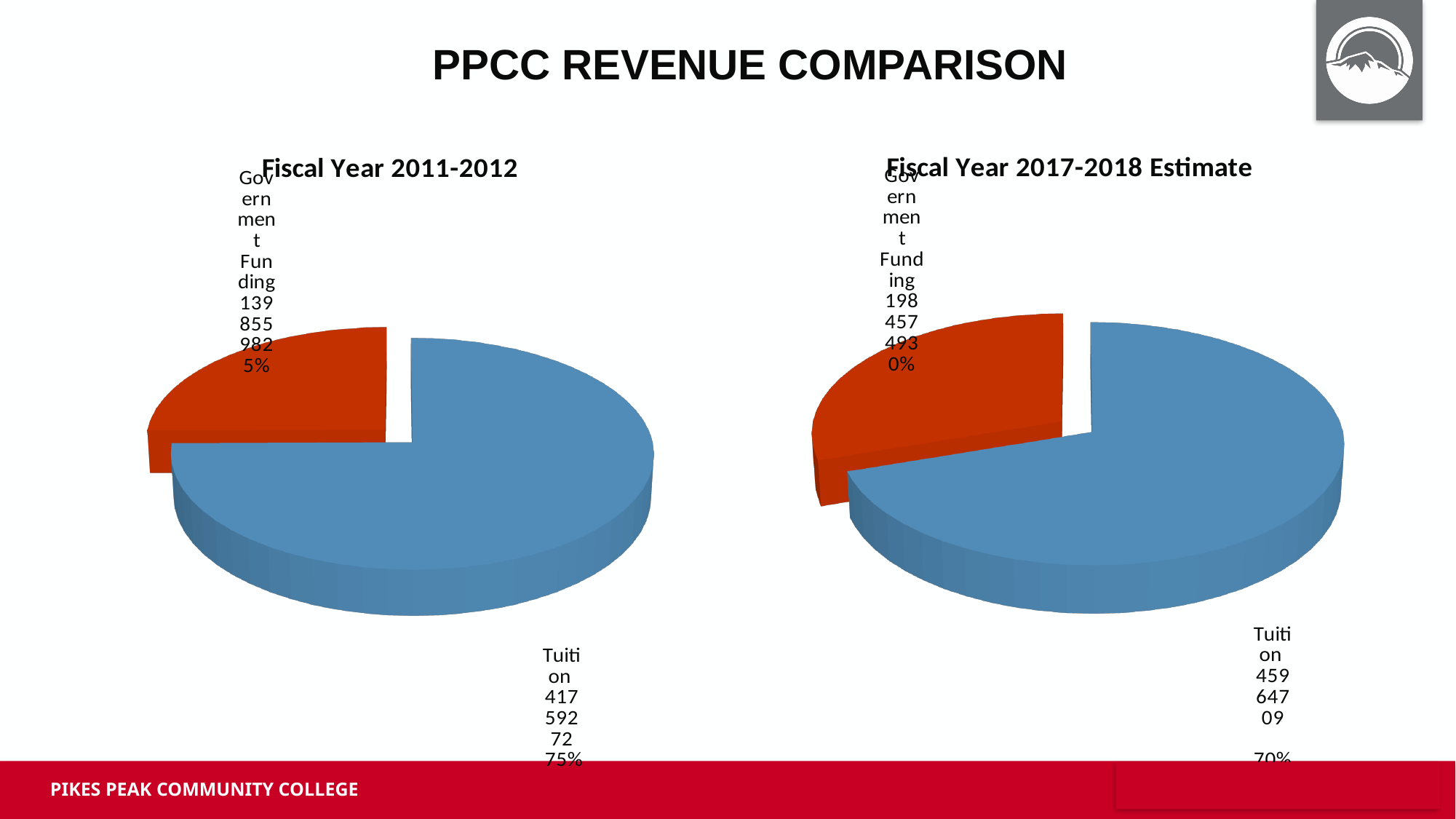
Which chart shows a larger Tuition share, Fiscal Year 2011-2012 or Fiscal Year 2017-2018 Estimate? Fiscal Year 2011-2012 What kind of chart is used for Fiscal Year 2011-2012? Pie chart In the Fiscal Year 2017-2018 Estimate chart, which category has the smallest slice? Government Funding In the Fiscal Year 2011-2012 chart, which category has the largest slice? Tuition What is the title of the slide containing the two pie charts? PPCC REVENUE COMPARISON In the Fiscal Year 2011-2012 chart, how many slices does the pie have? 2 In the Fiscal Year 2011-2012 chart, what colour is the Tuition slice? Blue In the Fiscal Year 2017-2018 Estimate chart, which is larger, Tuition or Government Funding? Tuition What kind of chart is used for Fiscal Year 2017-2018 Estimate? Pie chart In the Fiscal Year 2017-2018 Estimate chart, how many slices does the pie have? 2 In the Fiscal Year 2017-2018 Estimate chart, what share of the pie is Tuition? 70% In the Fiscal Year 2011-2012 chart, what share of the pie is Tuition? 75%